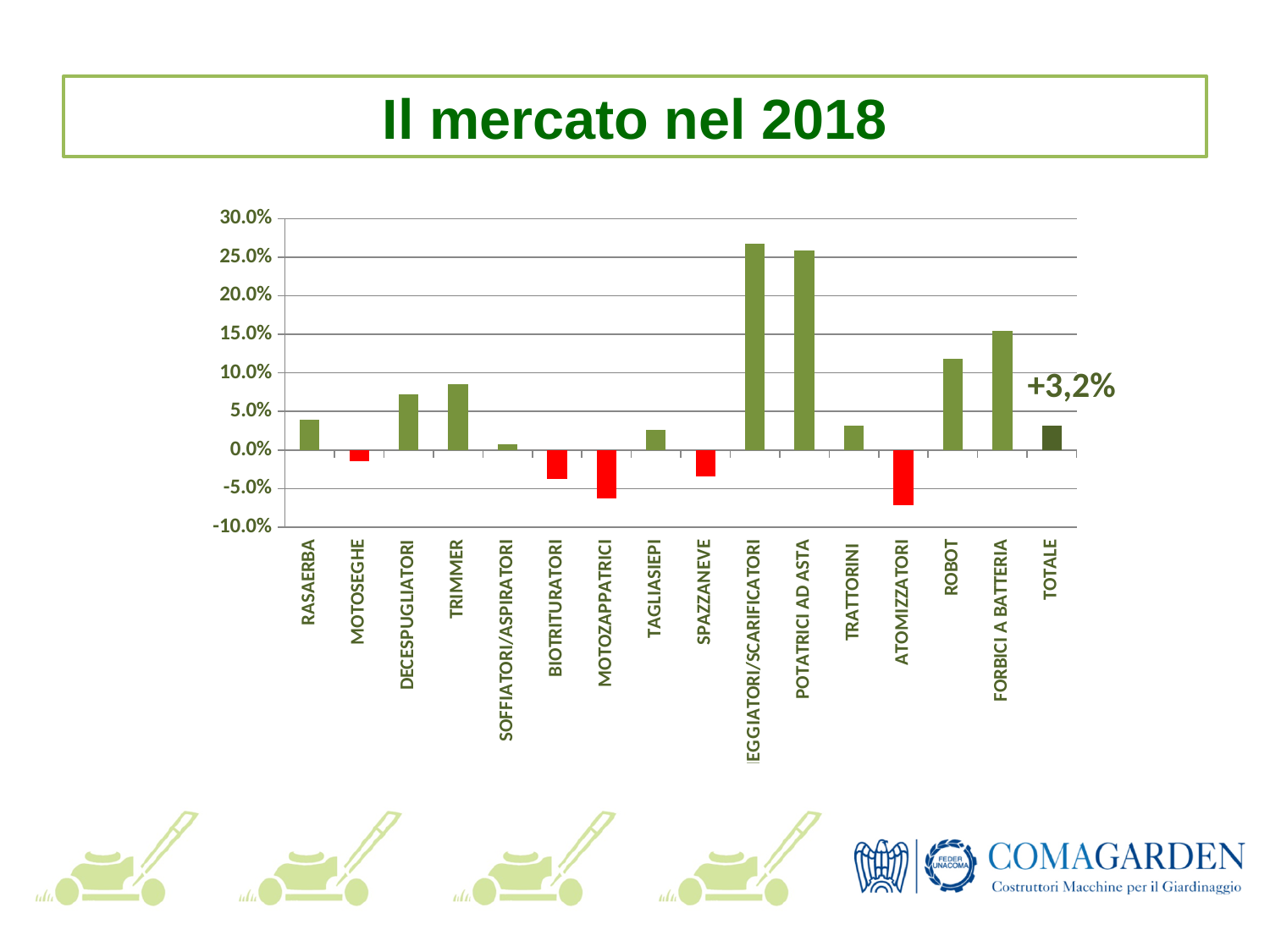
What kind of chart is shown on the slide? bar chart Is the value for ROBOT greater or less than 10.0%? greater What colour are the bars with negative values in the chart? red What value is labelled for the TOTALE bar? +3,2% Is the value for TRIMMER greater or less than 5.0%? greater Which has the larger value, ROBOT or FORBICI A BATTERIA? FORBICI A BATTERIA Is the value for ATOMIZZATORI greater or less than -5.0%? less What is the title of the chart on the slide? Il mercato nel 2018 Which has the larger value, TRIMMER or DECESPUGLIATORI? TRIMMER How many categories are shown on the x axis of the chart? 16